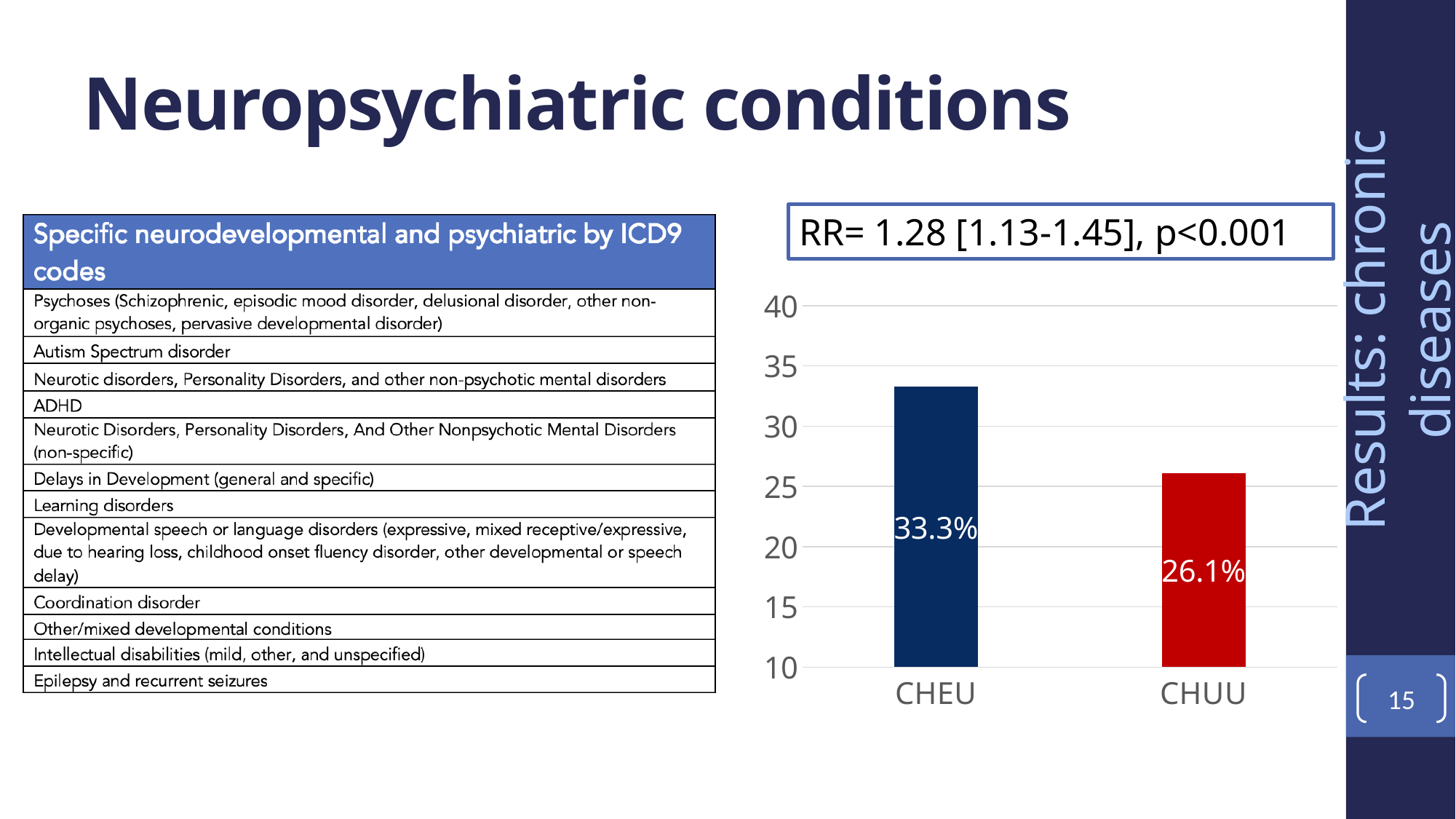
What is the value for CHEU? 33.3% What relative risk (RR) is stated in the box above the chart? RR= 1.28 [1.13-1.45], p<0.001 Is the value for CHEU greater or less than 30? greater What kind of chart is shown on the slide? bar chart What is the value for CHUU? 26.1% Which category has the lowest value? CHUU Which category has the highest value? CHEU What colour is the bar for CHUU? red Which is larger, the value for CHEU or the value for CHUU? CHEU How many categories are shown on the chart? 2 What is the difference between the values for CHEU and CHUU? 7.2% Is the value for CHUU greater or less than 30? less